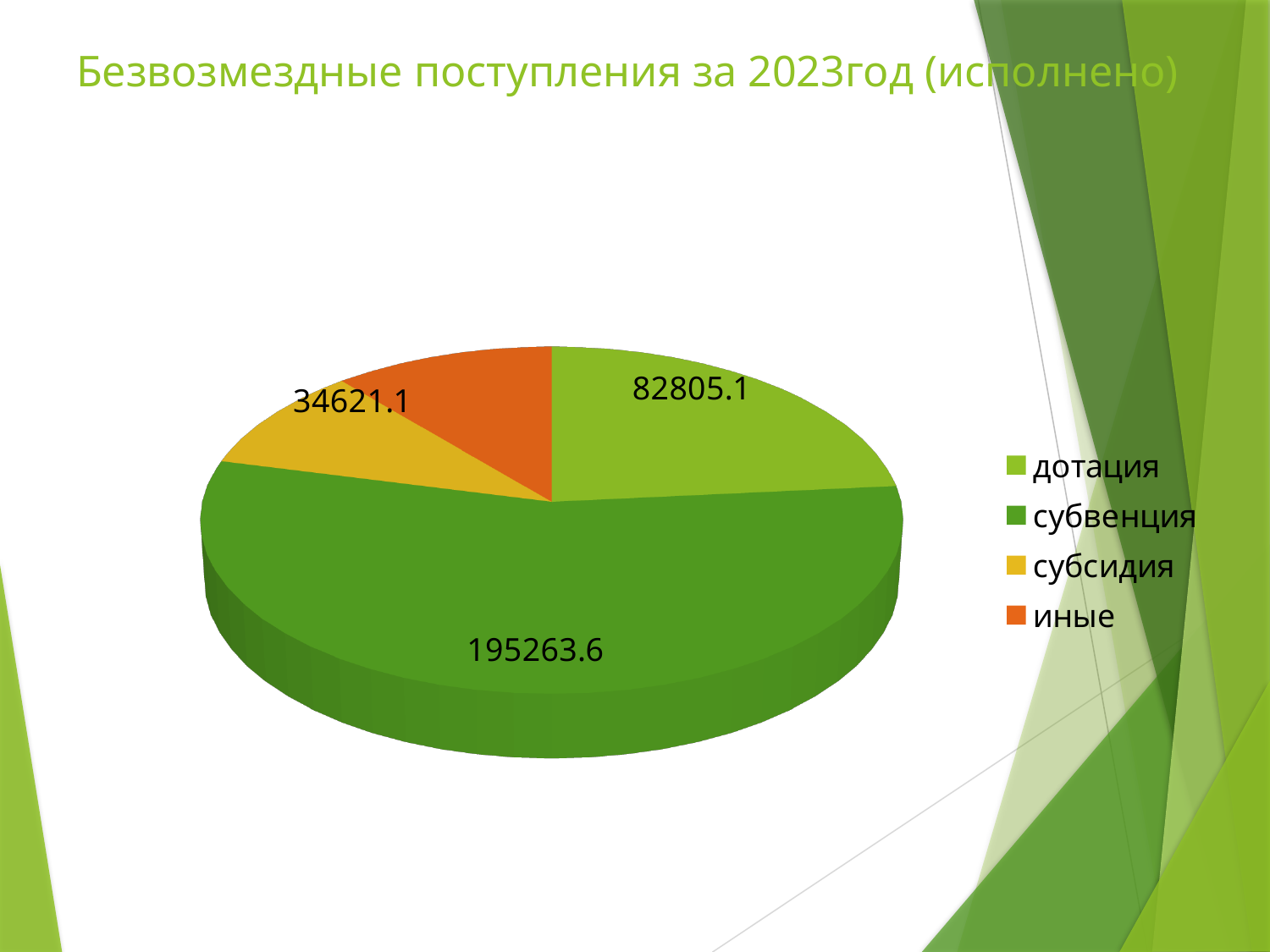
What is the value for дотация? 82805.1 Which category is shown in orange? иные What is the value for субвенция? 195263.6 What is the value for субсидия? 34621.1 Which is larger, дотация or субсидия? дотация Which category has the largest slice of the pie? субвенция Which is larger, субвенция or дотация? субвенция What is the difference between the values for субвенция and дотация? 112458.5 What type of chart is shown on the slide? pie chart How many categories does the legend list? 4 What is the difference between the values for дотация and субсидия? 48184.0 What is the title of the chart? Безвозмездные поступления за 2023год (исполнено)